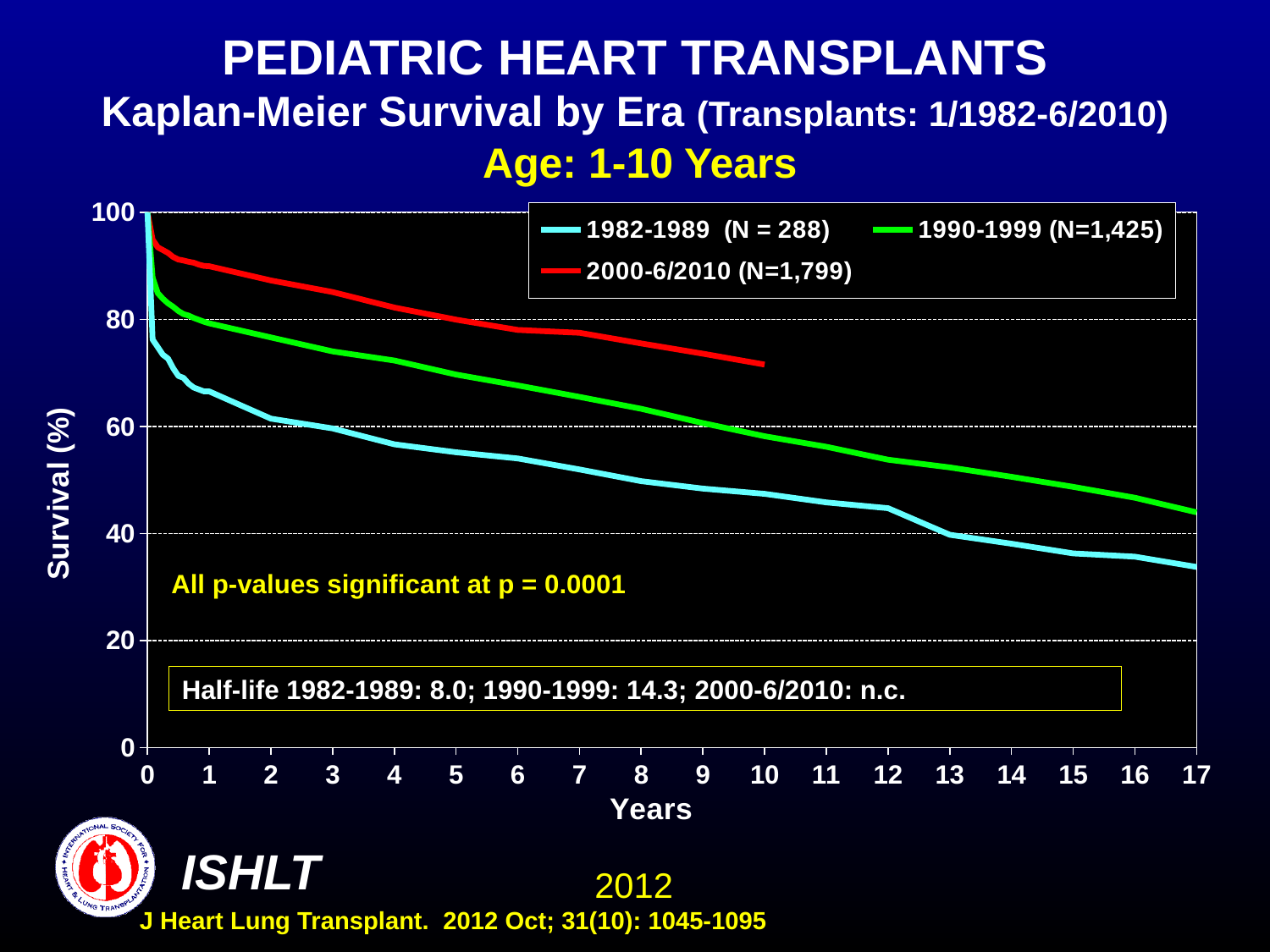
Is the survival value for the 2000-6/2010 era at 10 years greater or less than 60? greater Is the survival value for the 1990-1999 era at 5 years greater or less than 60? greater What is the highest year shown on the x axis? 17 At 5 years, which era has higher survival: 1982-1989 or 1990-1999? 1990-1999 What kind of chart is shown on the slide? Line chart Which era's survival curve ends earliest on the x axis? 2000-6/2010 Is the survival value for the 1982-1989 era at 15 years greater or less than 40? less How many series does the legend list? 3 Do the survival curves rise or fall as years increase? Fall What is the N shown in the legend for the 1990-1999 era? 1,425 Which era's survival curve is the lowest across the chart? 1982-1989